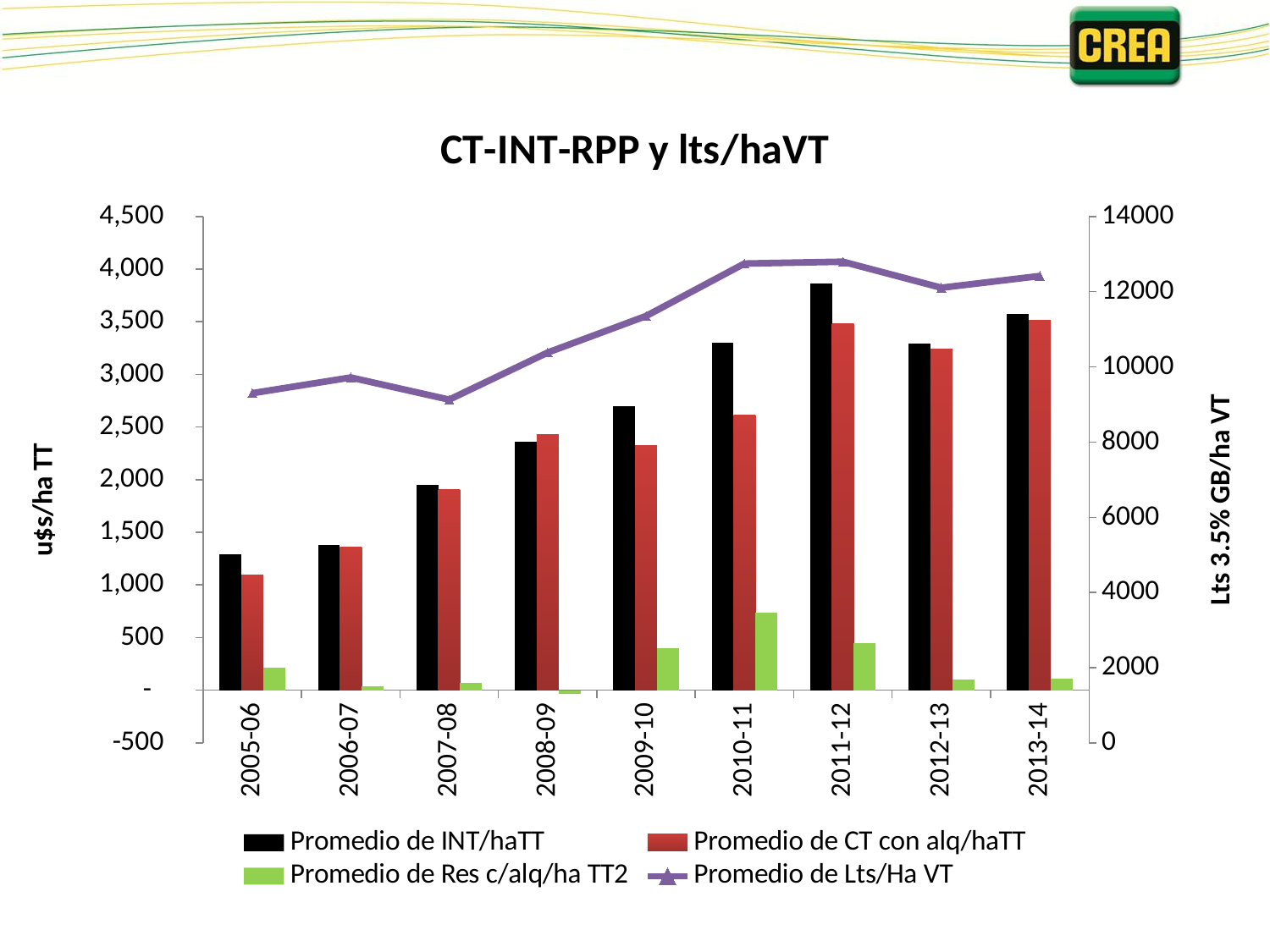
What kind of chart is shown on the slide? A combined bar and line chart What is the title of the right-hand vertical axis? Lts 3.5% GB/ha VT How many seasons (categories) are shown on the x axis? 9 How many series does the legend list? 4 Does Promedio de INT/haTT rise or fall from 2005-06 to 2011-12? Rise Is the value of Promedio de INT/haTT for 2011-12 greater or less than 3,500? greater In which season is Promedio de Res c/alq/ha TT2 lowest? 2008-09 In which season is Promedio de INT/haTT highest? 2011-12 Is the value of Promedio de Lts/Ha VT for 2010-11 greater or less than 12000? greater In which season is Promedio de Res c/alq/ha TT2 highest? 2010-11 In 2010-11, which is larger: Promedio de INT/haTT or Promedio de CT con alq/haTT? Promedio de INT/haTT Is the value of Promedio de CT con alq/haTT for 2005-06 greater or less than 1,500? less